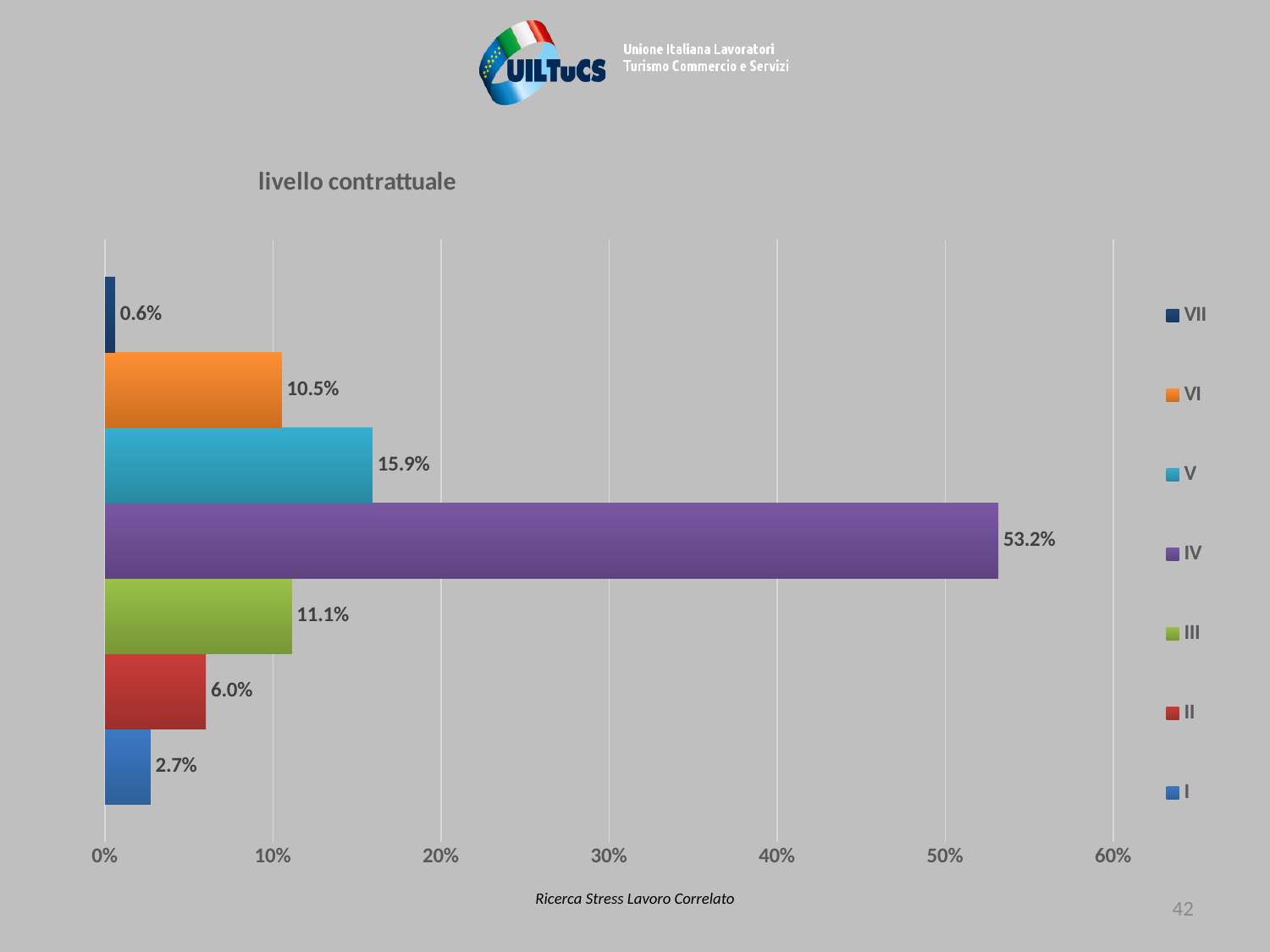
What is the value for level IV? 53.2% Which contractual level has the lowest value? VII What is the difference between the values for level V and level III? 4.8% What kind of chart is shown on the slide? bar chart What is the title of the chart? livello contrattuale Which contractual level has the highest value? IV Which is larger, the value for level II or the value for level VI? VI What is the value for level I? 2.7% Is the value for level IV greater or less than 50%? greater How many entries does the legend list? 7 How many contractual levels are shown in the chart? 7 What is the value for level VI? 10.5%